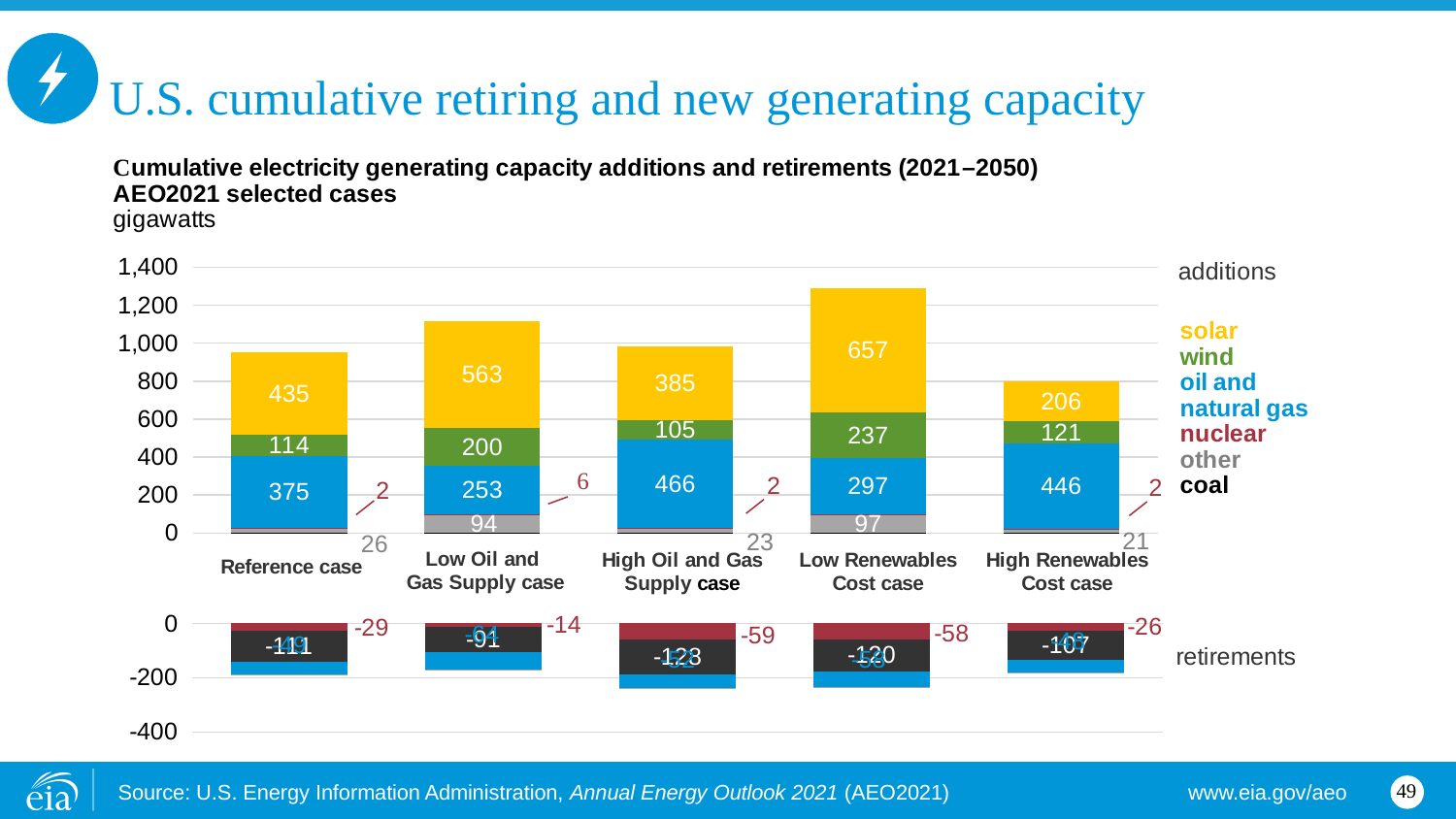
In the additions chart, which case has the highest solar capacity addition? Low Renewables Cost case In the additions chart, what is the 'other' capacity addition for the Low Oil and Gas Supply case? 94 In the additions chart, what is the oil and natural gas capacity addition for the High Oil and Gas Supply case? 466 How many fuel categories does the legend list? 6 In the additions chart, is the total addition for the Reference case greater or less than 1,000 gigawatts? less How many cases are shown along the x axis of the additions chart? 5 In the additions chart, which case has the larger wind addition: the Low Renewables Cost case or the Low Oil and Gas Supply case? Low Renewables Cost case In the additions chart, what is the solar capacity addition for the Low Renewables Cost case? 657 In the additions chart, how much larger is the solar addition in the Low Oil and Gas Supply case than in the Reference case? 128 What kind of chart is used to show the capacity additions? Stacked bar chart In the additions chart, which case has the lowest solar capacity addition? High Renewables Cost case In the retirements chart, what is the nuclear retirement value for the High Oil and Gas Supply case? -59